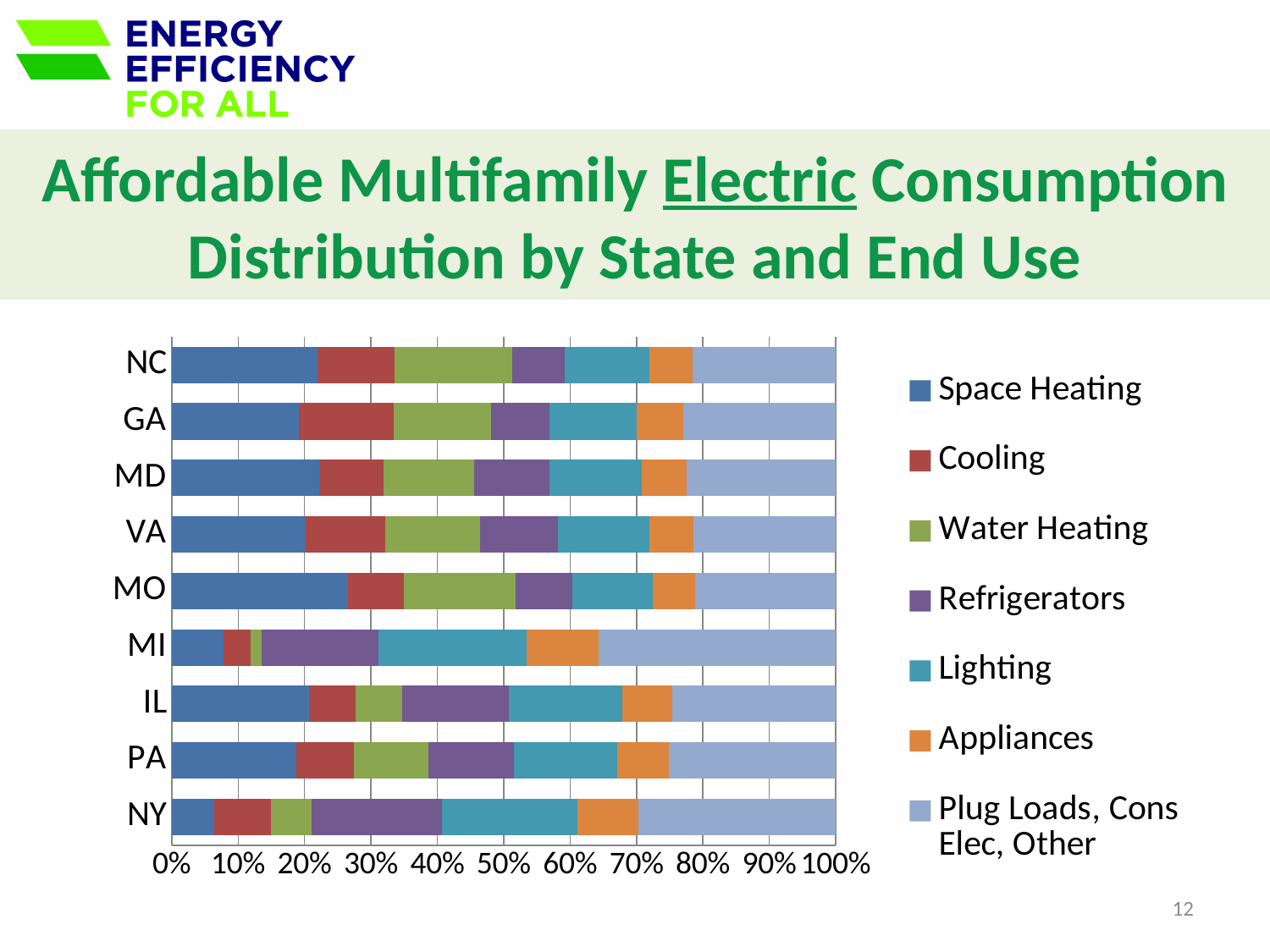
How many states are listed on the vertical axis of the chart? 9 Which state has a larger Lighting share, MI or NC? MI Is the Space Heating share for NY greater or less than 10%? less What is the last entry listed in the chart legend? Plug Loads, Cons Elec, Other Which state has the largest Plug Loads, Cons Elec, Other share of electric consumption? MI Is the Space Heating share for MO greater or less than 20%? greater Which state has the smallest Water Heating share of electric consumption? MI How many series does the chart legend list? 7 What kind of chart is shown on the slide? Stacked bar chart Which state has the largest Space Heating share of electric consumption? MO Which state has the largest Cooling share of electric consumption? GA Which state has a larger Refrigerators share, NY or NC? NY